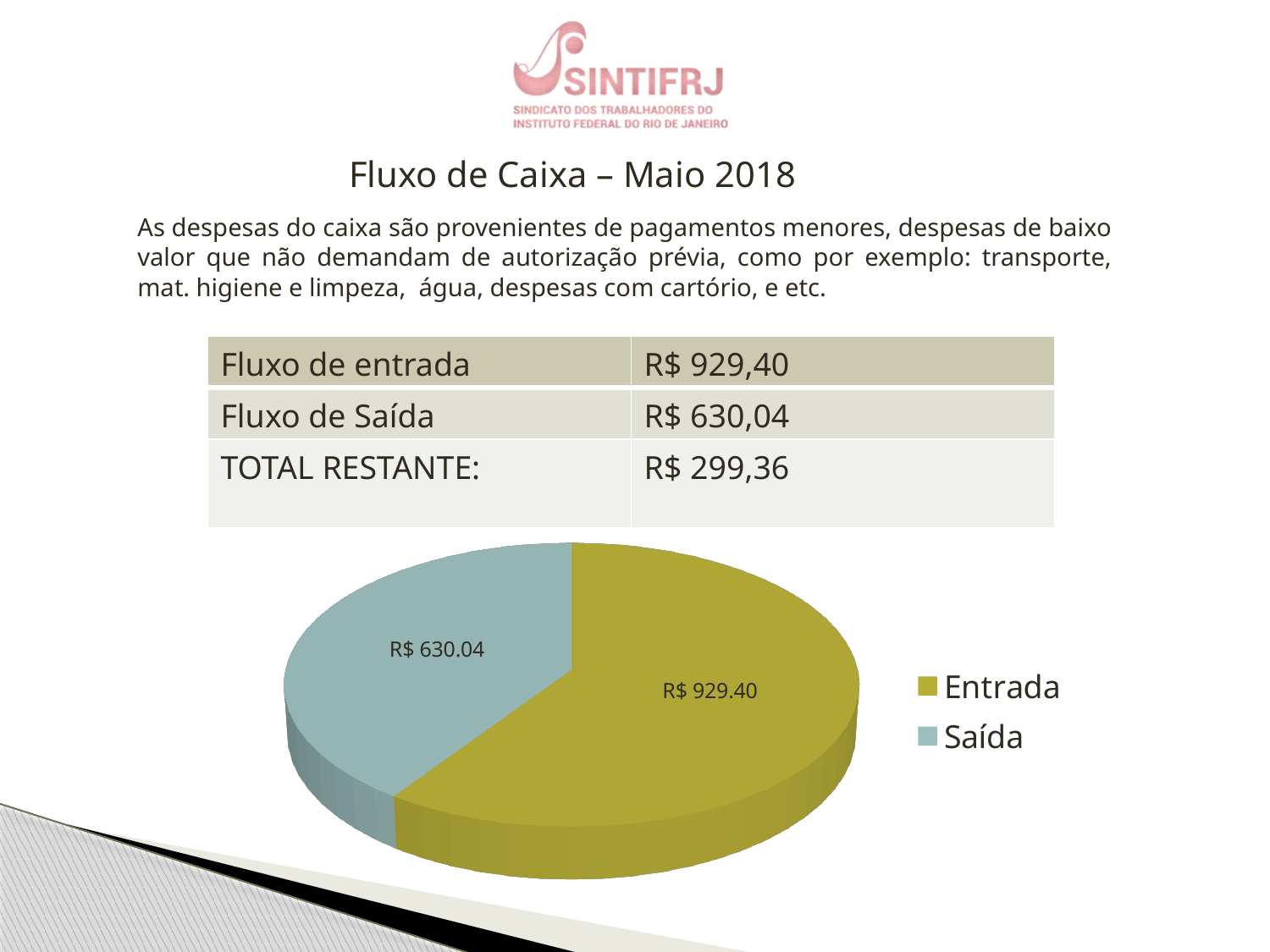
What kind of chart is shown on the slide? pie chart Which is larger in the pie chart, Entrada or Saída? Entrada How many entries does the pie chart's legend list? 2 What colour is the Entrada slice in the pie chart? olive green Which slice of the pie chart is the largest? Entrada What are the two legend entries of the pie chart? Entrada and Saída How many slices does the pie chart have? 2 What is the value of the Entrada slice in the pie chart? R$ 929.40 What is the value of the Saída slice in the pie chart? R$ 630.04 Which slice of the pie chart is the smallest? Saída What is the difference between the Entrada and Saída values in the pie chart? R$ 299.36